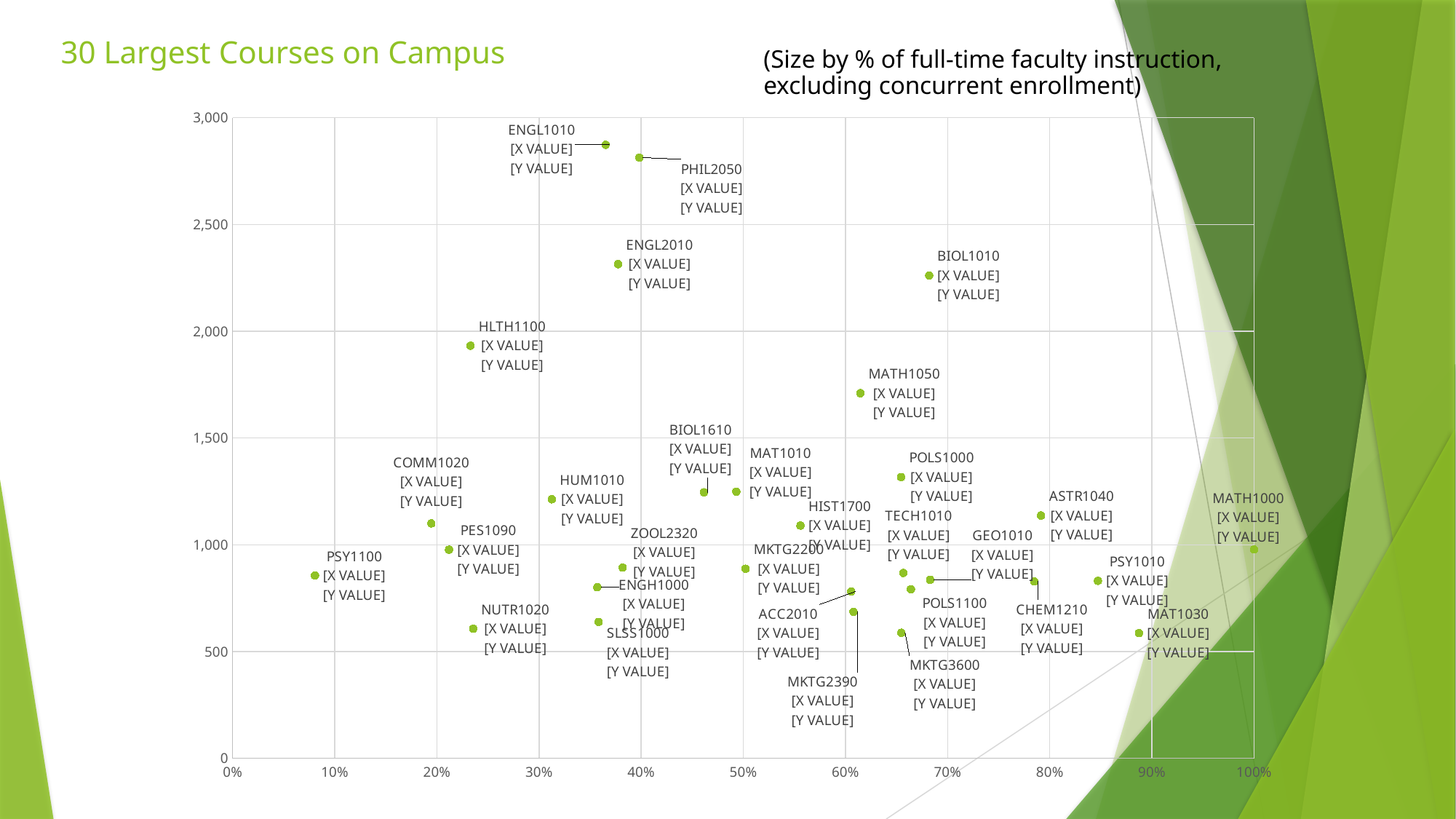
Which course is plotted furthest to the left on the horizontal axis? PSY1100 What kind of chart is shown on the slide? scatter chart What is the title of the chart? 30 Largest Courses on Campus Is the vertical-axis value for BIOL1010 greater or less than 2,000? greater Which course has the higher vertical-axis value, ENGL2010 or HLTH1100? ENGL2010 How many courses are plotted on the chart? 30 Which course is plotted furthest to the right on the horizontal axis? MATH1000 Is the vertical-axis value for HLTH1100 greater or less than 2,000? less Which course has the highest value on the vertical axis? ENGL1010 Is the horizontal-axis value for PSY1100 greater or less than 10%? less Which course has the higher vertical-axis value, BIOL1010 or MATH1050? BIOL1010